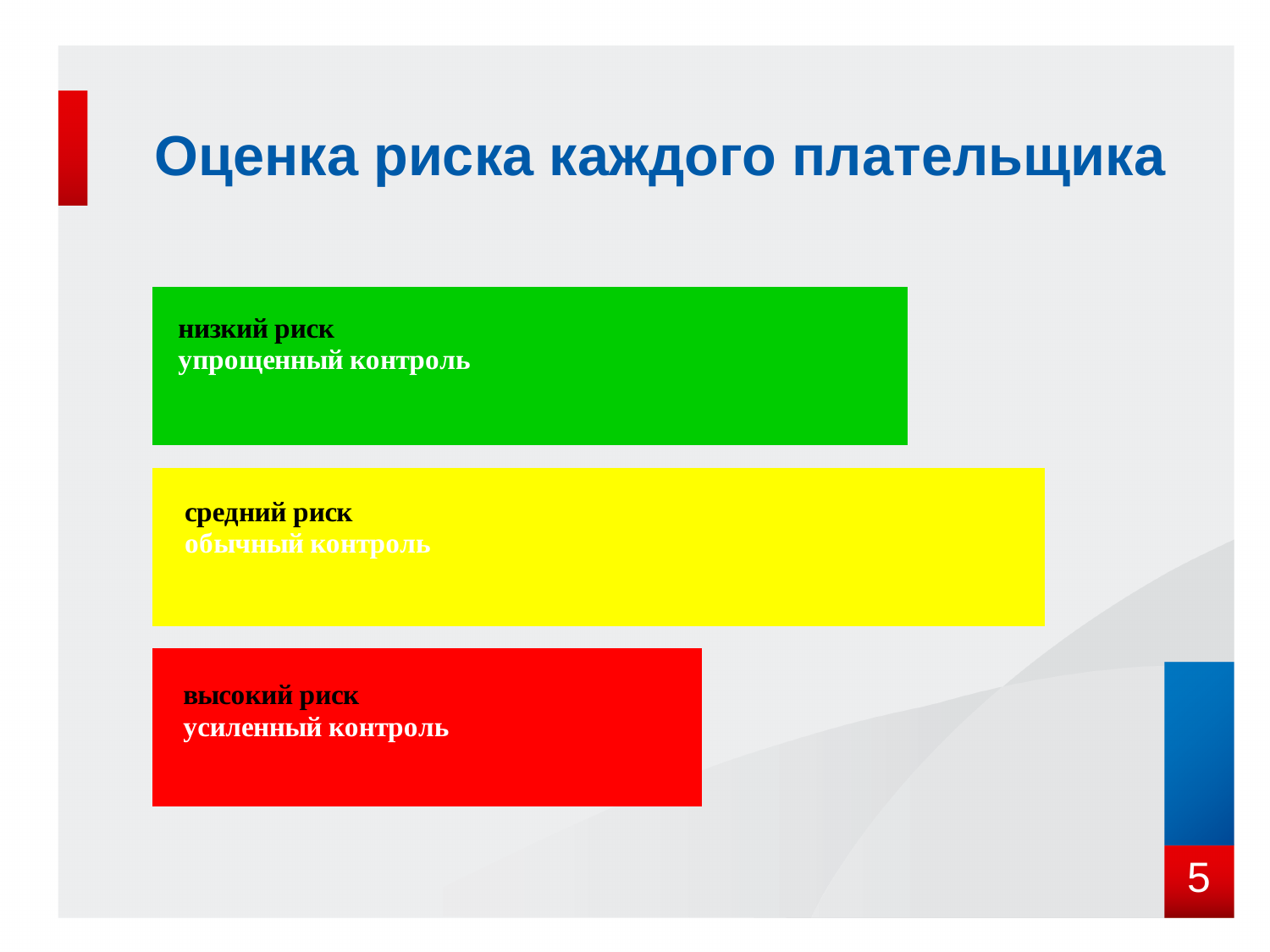
Which bar is longer, низкий риск or высокий риск? низкий риск What type of control is listed on the bar for низкий риск? упрощенный контроль Which category has the shortest bar? высокий риск What kind of chart is shown on the slide? bar chart Which category has the longest bar? средний риск Which bar is longer, средний риск or низкий риск? средний риск What type of control is listed on the bar for высокий риск? усиленный контроль What is the title of the slide? Оценка риска каждого плательщика How many bars are shown in the chart? 3 What colour is the bar for высокий риск? red